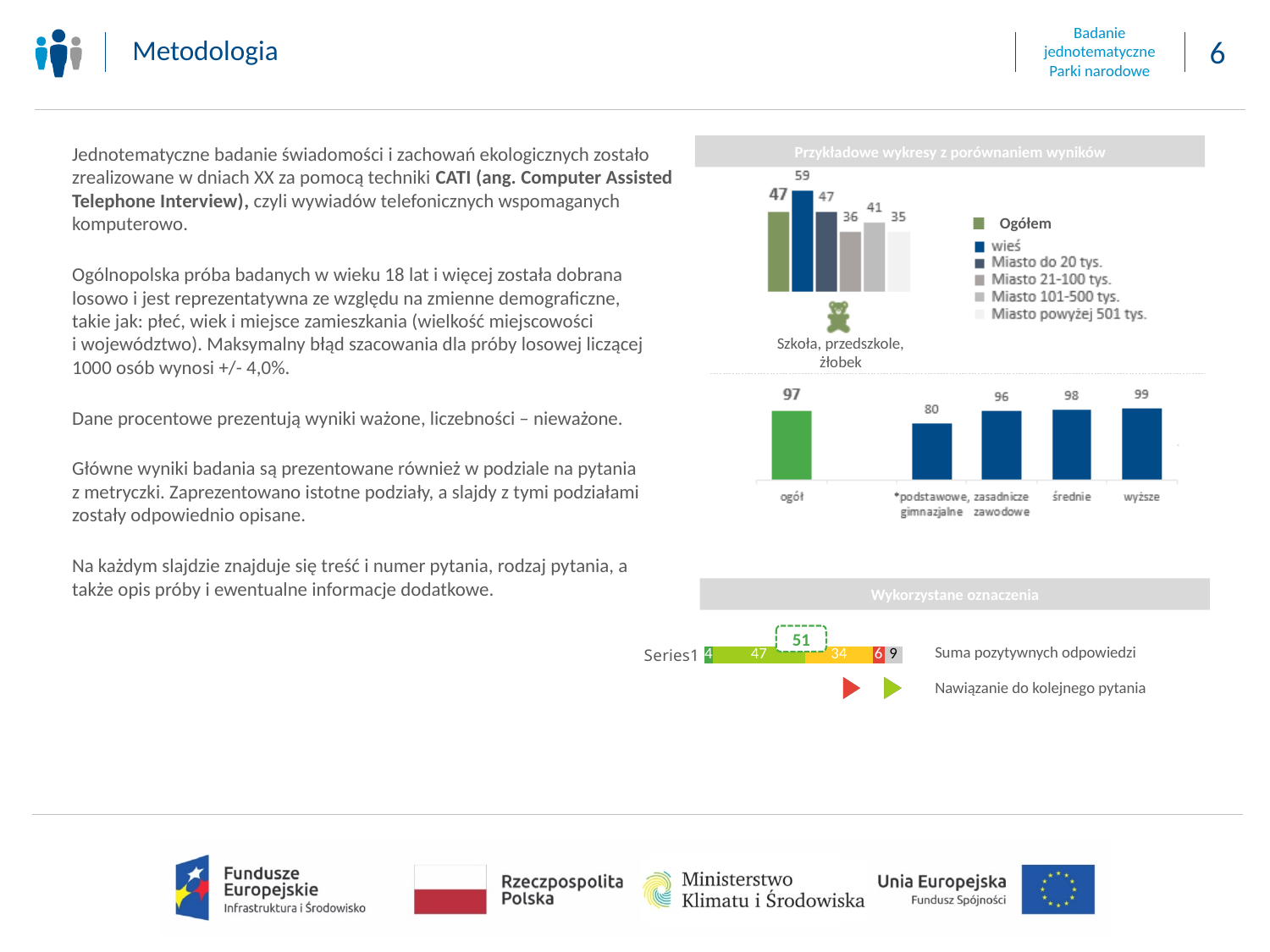
In the chart labelled "Szkoła, przedszkole, żłobek", which category has the lowest value? Miasto powyżej 501 tys. In the chart labelled "Szkoła, przedszkole, żłobek", what is the difference between the values for wieś and Miasto 21-100 tys.? 23 In the stacked bar chart under "Wykorzystane oznaczenia", what is the sum of positive answers shown above the bar? 51 In the middle chart on the right (education levels), what is the difference between the values for wyższe and podstawowe, gimnazjalne? 19 In the middle chart on the right (education levels), which category has the lowest value? podstawowe, gimnazjalne In the chart labelled "Szkoła, przedszkole, żłobek", how many series does the legend list? 6 In the chart labelled "Szkoła, przedszkole, żłobek", which category has the highest value? wieś In the middle chart on the right (education levels), how many bars are plotted? 5 In the chart labelled "Szkoła, przedszkole, żłobek", what is the value for wieś? 59 In the middle chart on the right (education levels), what is the value for ogół? 97 In the chart labelled "Szkoła, przedszkole, żłobek", what is the value for Ogółem? 47 In the middle chart on the right (education levels), what is the value for średnie? 98